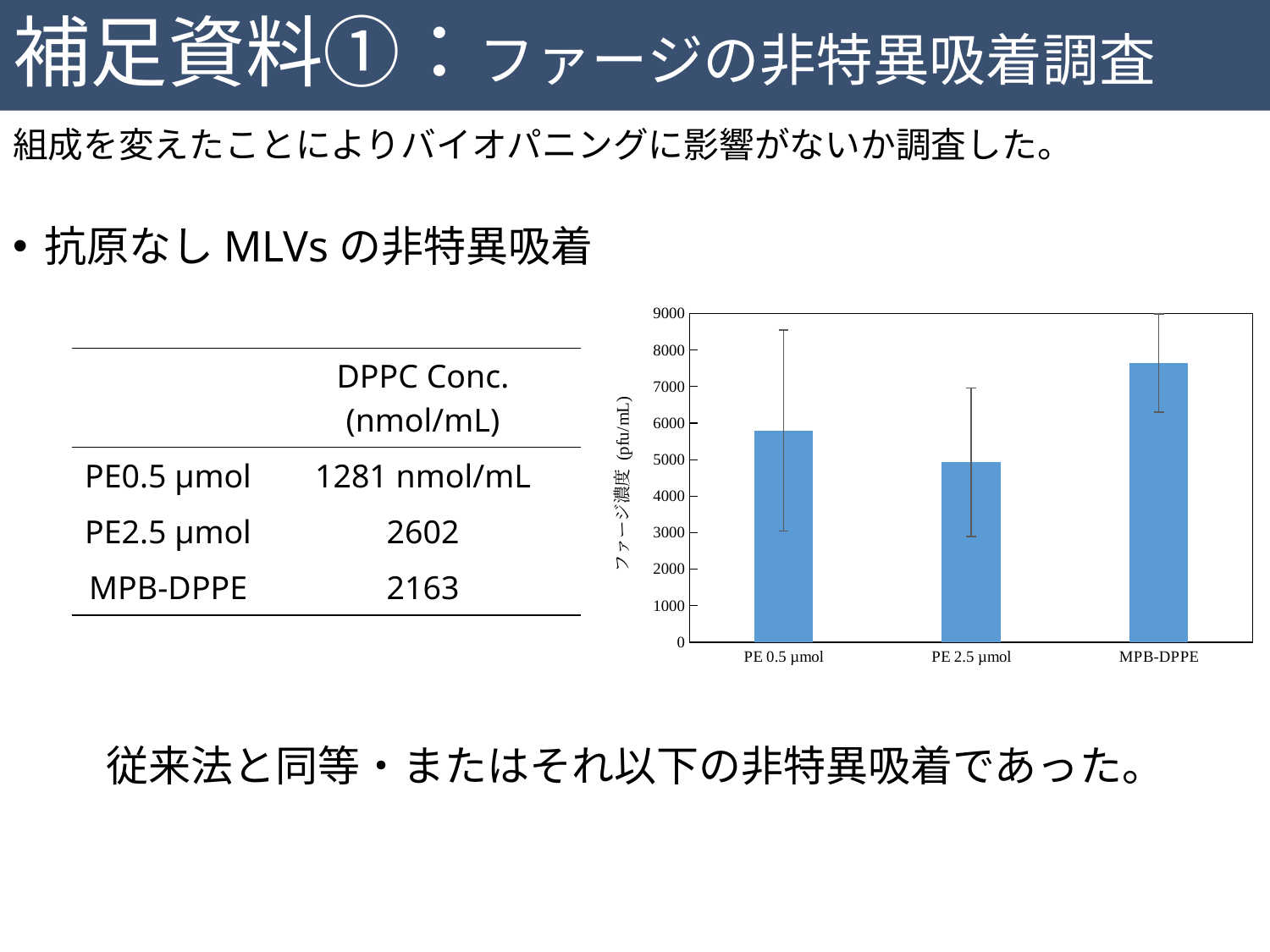
Which bar is taller, PE 0.5 µmol or PE 2.5 µmol? PE 0.5 µmol Is the value for PE 2.5 µmol greater or less than 4000? greater What is the label of the y axis of the bar chart? ファージ濃度 (pfu/mL) Which bar is taller, MPB-DPPE or PE 0.5 µmol? MPB-DPPE What kind of chart is shown on the slide? bar chart Is the value for PE 0.5 µmol greater or less than 5000? greater What is the highest tick value shown on the y axis of the bar chart? 9000 Which category has the highest bar in the chart? MPB-DPPE How many categories are plotted on the x axis of the bar chart? 3 Which category has the lowest bar in the chart? PE 2.5 µmol Is the value for MPB-DPPE greater or less than 7000? greater